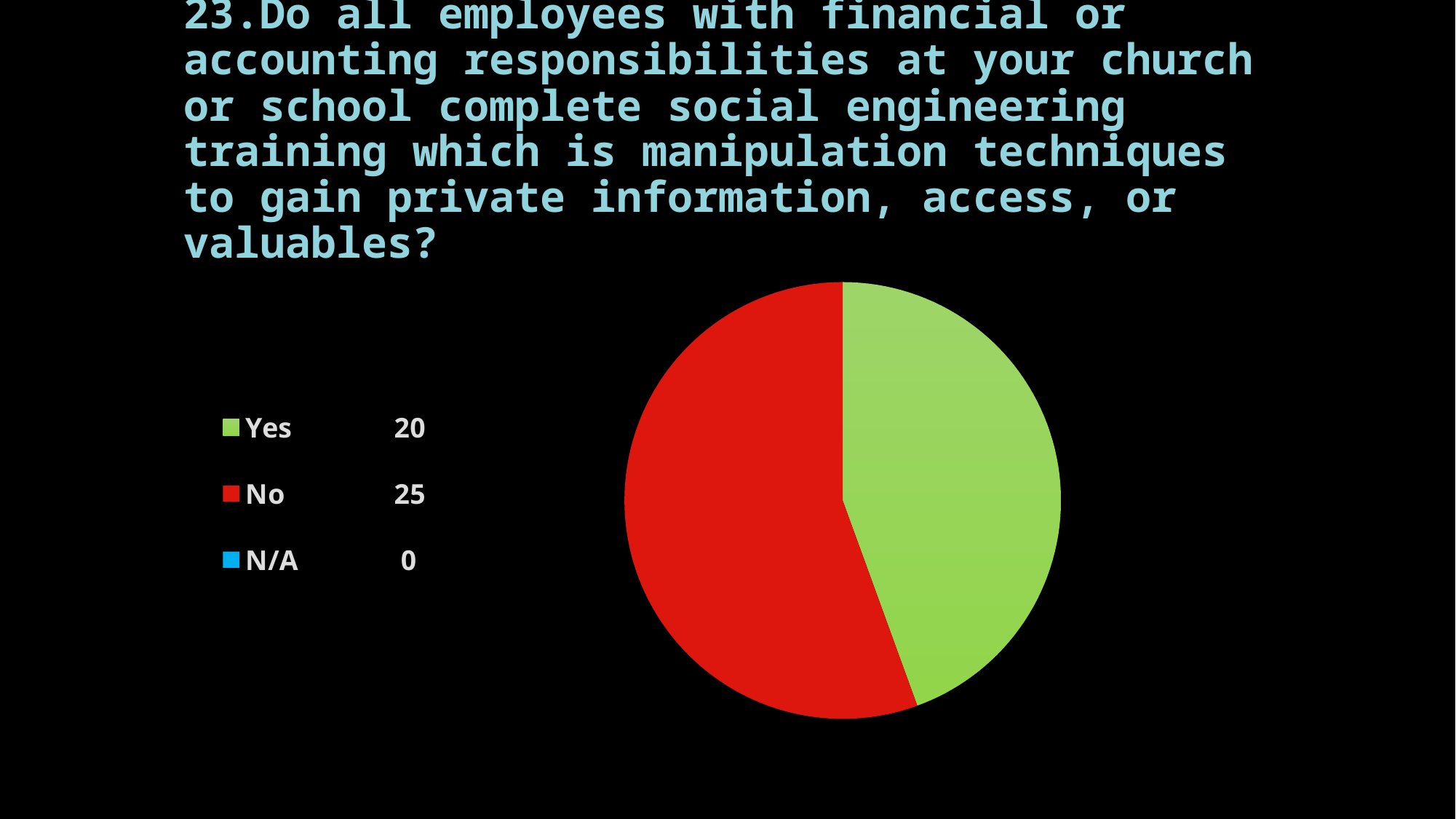
What colour represents the No slice? red What kind of chart is shown on the slide? pie chart What is the value for N/A? 0 What is the value for Yes? 20 How many categories does the legend list? 3 What is the value for No? 25 Which category has the highest value? No What is the difference between the No and Yes values? 5 Which is larger, Yes or No? No Which category has the lowest value? N/A What is the total of all the values shown? 45 What colour represents the Yes slice? green